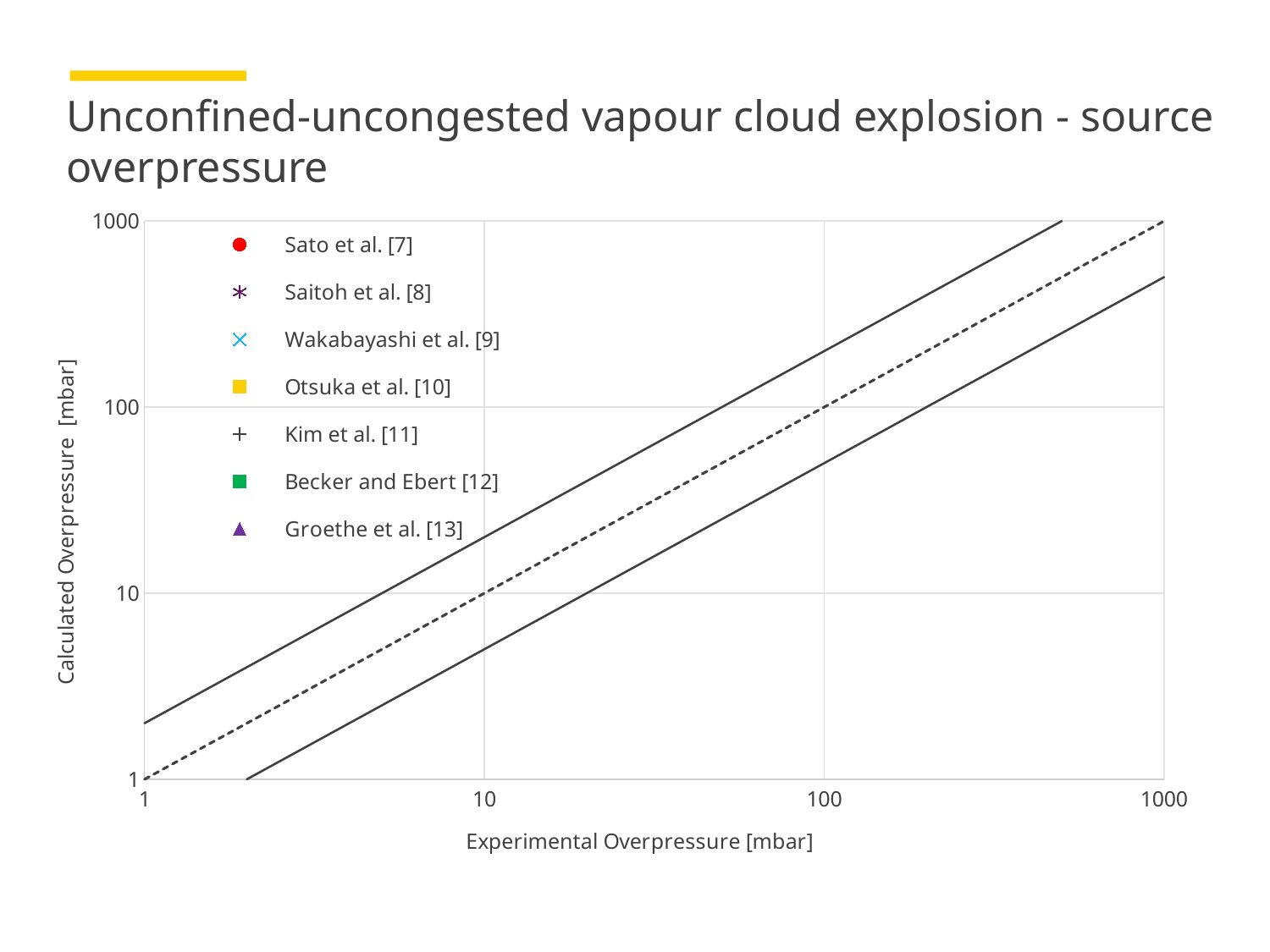
Do the reference lines rise or fall as experimental overpressure increases along the x axis? rise What calculated overpressure does the dashed line reach at an experimental overpressure of 100 mbar? 100 What kind of chart is shown on the slide? scatter chart How many series does the legend list? 7 At an experimental overpressure of 10 mbar, is the value of the lower solid line greater or less than 10? less What is the highest value shown on the x axis? 1000 What is the title of the chart on the slide? Unconfined-uncongested vapour cloud explosion - source overpressure How many reference lines are drawn on the chart? 3 What is the label of the x axis? Experimental Overpressure [mbar] What calculated overpressure does the dashed line reach at an experimental overpressure of 10 mbar? 10 What is the lowest value shown on the y axis? 1 At an experimental overpressure of 10 mbar, is the value of the upper solid line greater or less than 10? greater